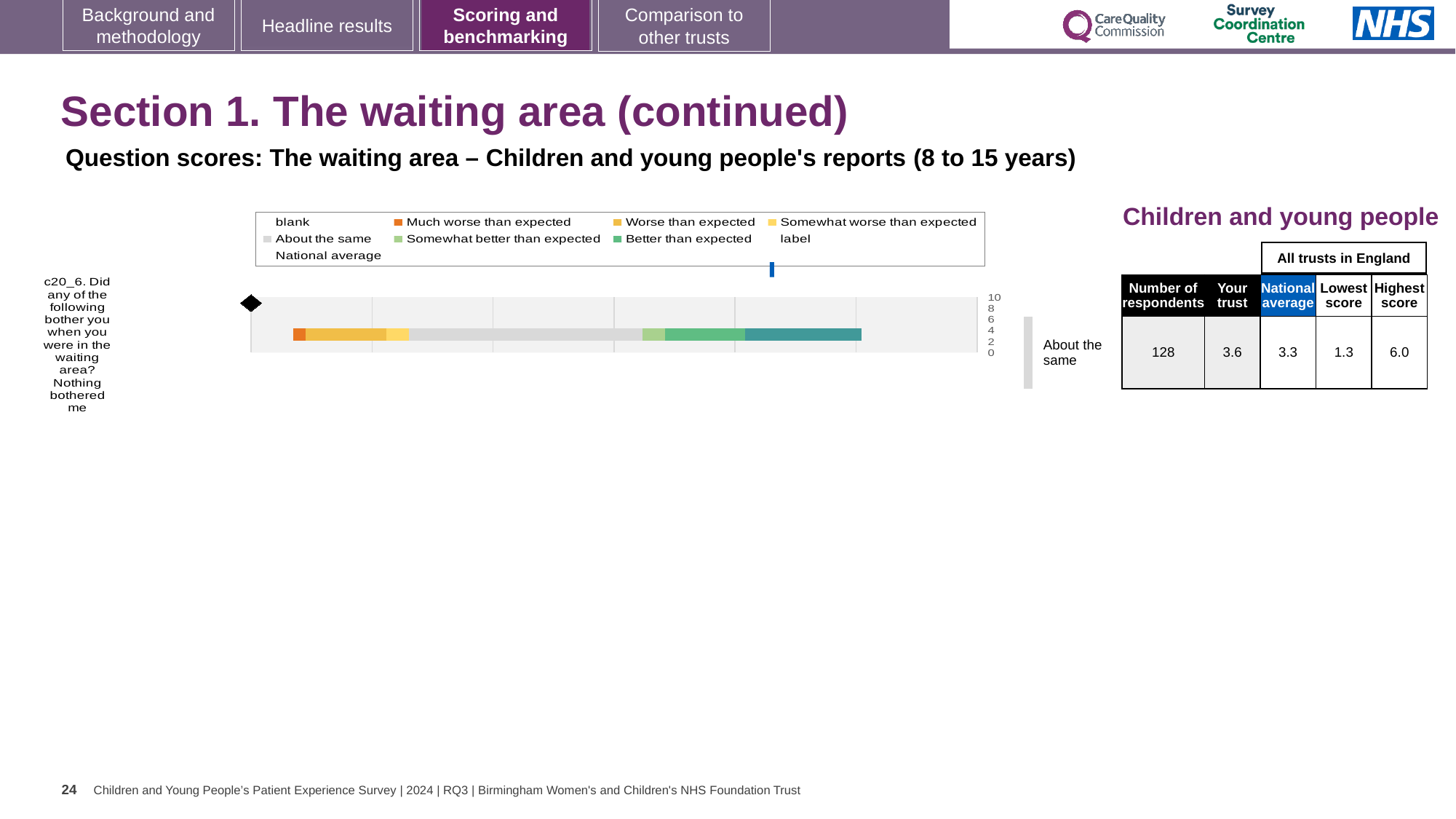
What kind of chart is shown on the slide for question c20_6? bar chart How many entries does the chart legend list? 9 In the table next to the chart, what is the lowest score across all trusts in England for c20_6? 1.3 Which benchmark category is the trust's result for c20_6 labelled as on the chart? About the same What is the difference between the highest score and the lowest score for c20_6 in the table? 4.7 Which is larger for c20_6, the 'Your trust' score or the national average? Your trust In the table next to the chart, how many respondents answered c20_6? 128 How many survey questions are plotted in the chart? 1 In the table next to the chart, what is the national average score for c20_6? 3.3 In the table next to the chart, what is the 'Your trust' score for c20_6? 3.6 What colour does the legend use for 'Much worse than expected'? orange In the table next to the chart, what is the highest score across all trusts in England for c20_6? 6.0